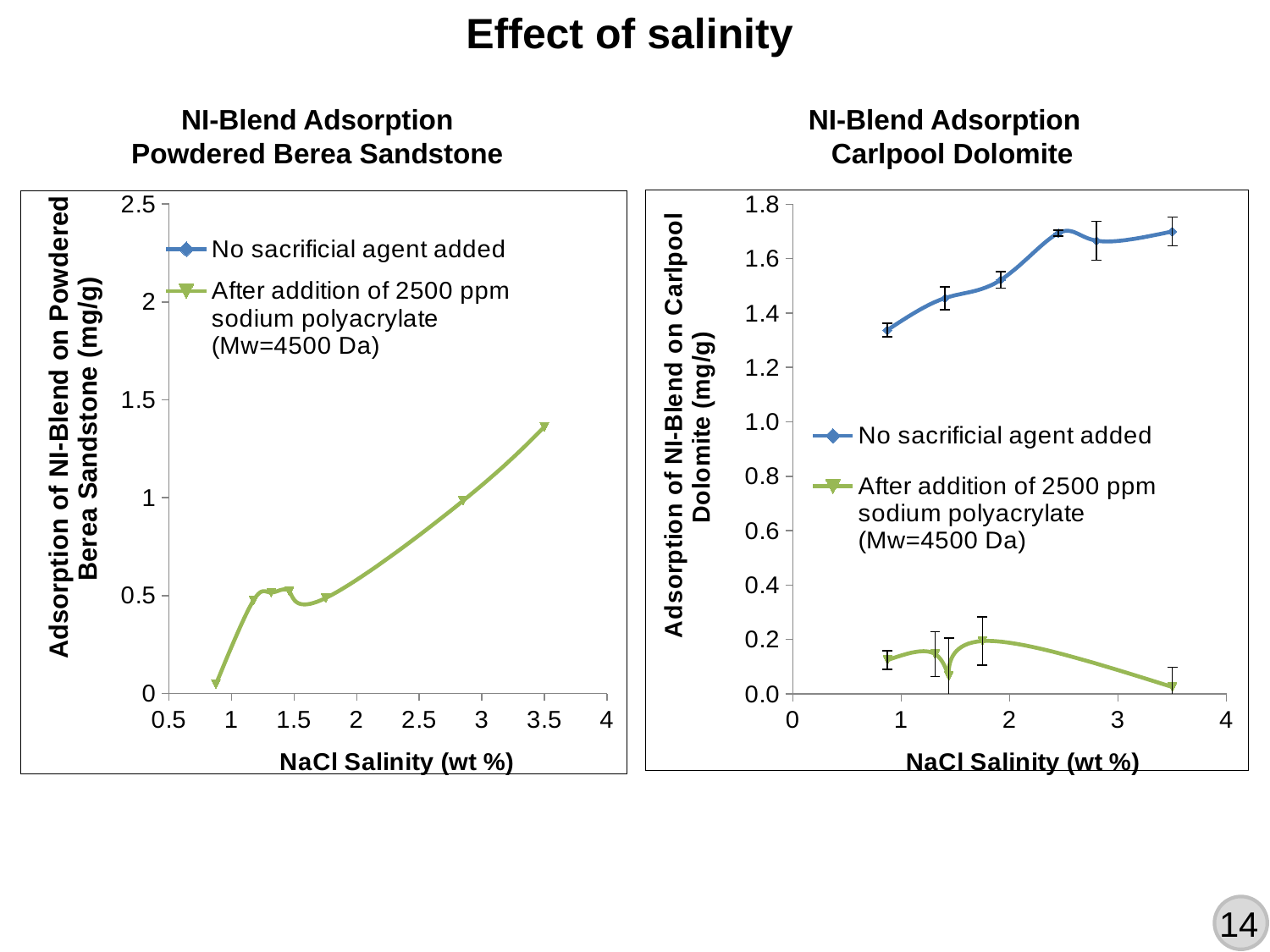
In the NI-Blend Adsorption Carlpool Dolomite chart, what colour is the line for 'No sacrificial agent added'? blue How many data points are plotted on the NI-Blend Adsorption Powdered Berea Sandstone chart? 7 How many series does the legend of the NI-Blend Adsorption Carlpool Dolomite chart list? 2 In the NI-Blend Adsorption Carlpool Dolomite chart, is the value for 'After addition of 2500 ppm sodium polyacrylate' at 3.5 wt % NaCl greater or less than 0.2? less In the NI-Blend Adsorption Carlpool Dolomite chart, does the 'No sacrificial agent added' series generally rise or fall as NaCl salinity increases? rise What kind of chart is the NI-Blend Adsorption Powdered Berea Sandstone chart? line chart In the NI-Blend Adsorption Powdered Berea Sandstone chart, is the value for 'After addition of 2500 ppm sodium polyacrylate' at 3.5 wt % NaCl greater or less than 1? greater In the NI-Blend Adsorption Carlpool Dolomite chart, is the value for 'No sacrificial agent added' at 3.5 wt % NaCl greater or less than 1.6? greater In the NI-Blend Adsorption Carlpool Dolomite chart, which series has the larger value at 3.5 wt % NaCl salinity? No sacrificial agent added What is the x-axis title of the NI-Blend Adsorption Carlpool Dolomite chart? NaCl Salinity (wt %) In the NI-Blend Adsorption Powdered Berea Sandstone chart, does the plotted adsorption generally rise or fall as NaCl salinity increases? rise